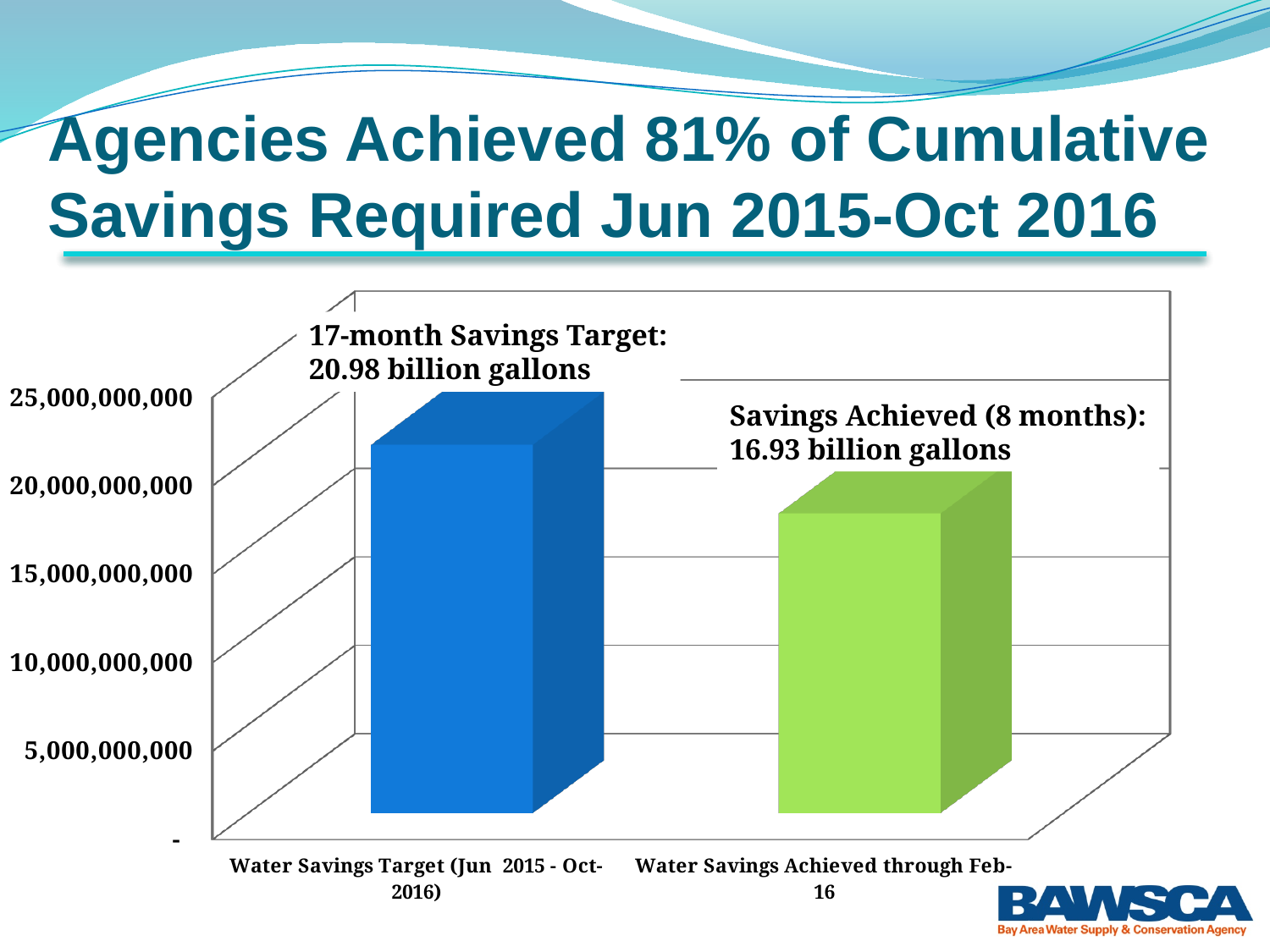
Is the value for Water Savings Achieved through Feb-16 greater or less than 15,000,000,000? greater Which category has the lowest value on the chart? Water Savings Achieved through Feb-16 What type of chart is shown on the slide? Bar chart Which category has the highest value on the chart? Water Savings Target (Jun 2015 - Oct-2016) What is the difference between the 17-month savings target and the savings achieved, in billion gallons? 4.05 billion gallons What is the savings achieved (8 months) value shown on the chart? 16.93 billion gallons Which bar is taller: Water Savings Target or Water Savings Achieved through Feb-16? Water Savings Target Is the value for Water Savings Target (Jun 2015 - Oct-2016) greater or less than 20,000,000,000? greater How many bars are plotted on the chart? 2 What colour is the bar for Water Savings Achieved through Feb-16? Green Is the value for Water Savings Achieved through Feb-16 greater or less than 20,000,000,000? less What is the 17-month savings target shown on the chart? 20.98 billion gallons